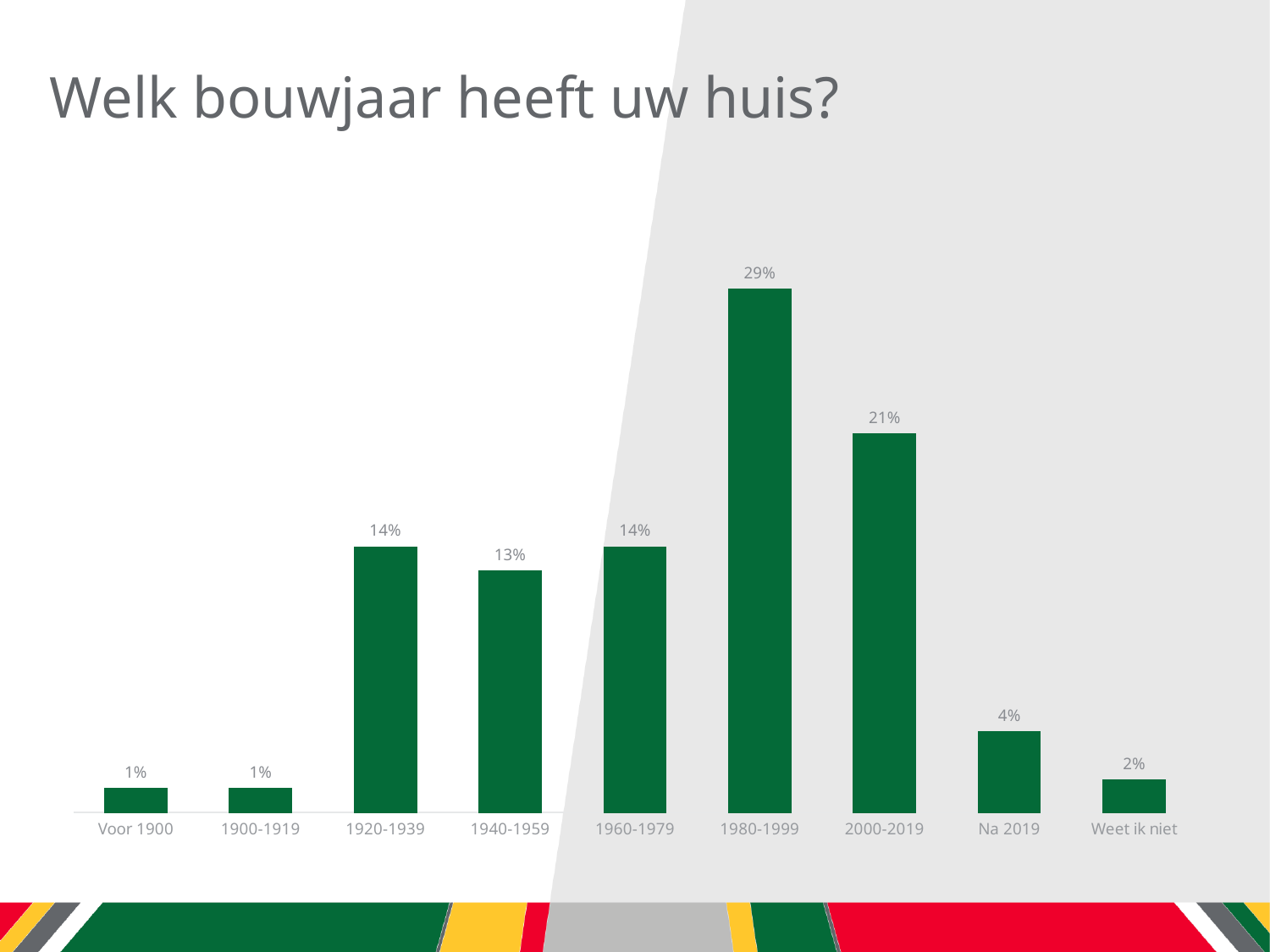
What is the title of the slide? Welk bouwjaar heeft uw huis? What percentage of respondents said their house was built in 1980-1999? 29% How many categories are shown on the x axis of the chart? 9 Which building-period category has the highest percentage? 1980-1999 What colour are the bars in the chart? Green What is the value shown for the 2000-2019 category? 21% What is the difference between the values for 1980-1999 and 2000-2019? 8% What kind of chart is shown on the slide? Bar chart What is the difference between the values for 1920-1939 and 1940-1959? 1% What percentage is shown for 'Na 2019'? 4% What is the value for 'Weet ik niet'? 2% Which is larger, the value for 1940-1959 or the value for 1960-1979? 1960-1979